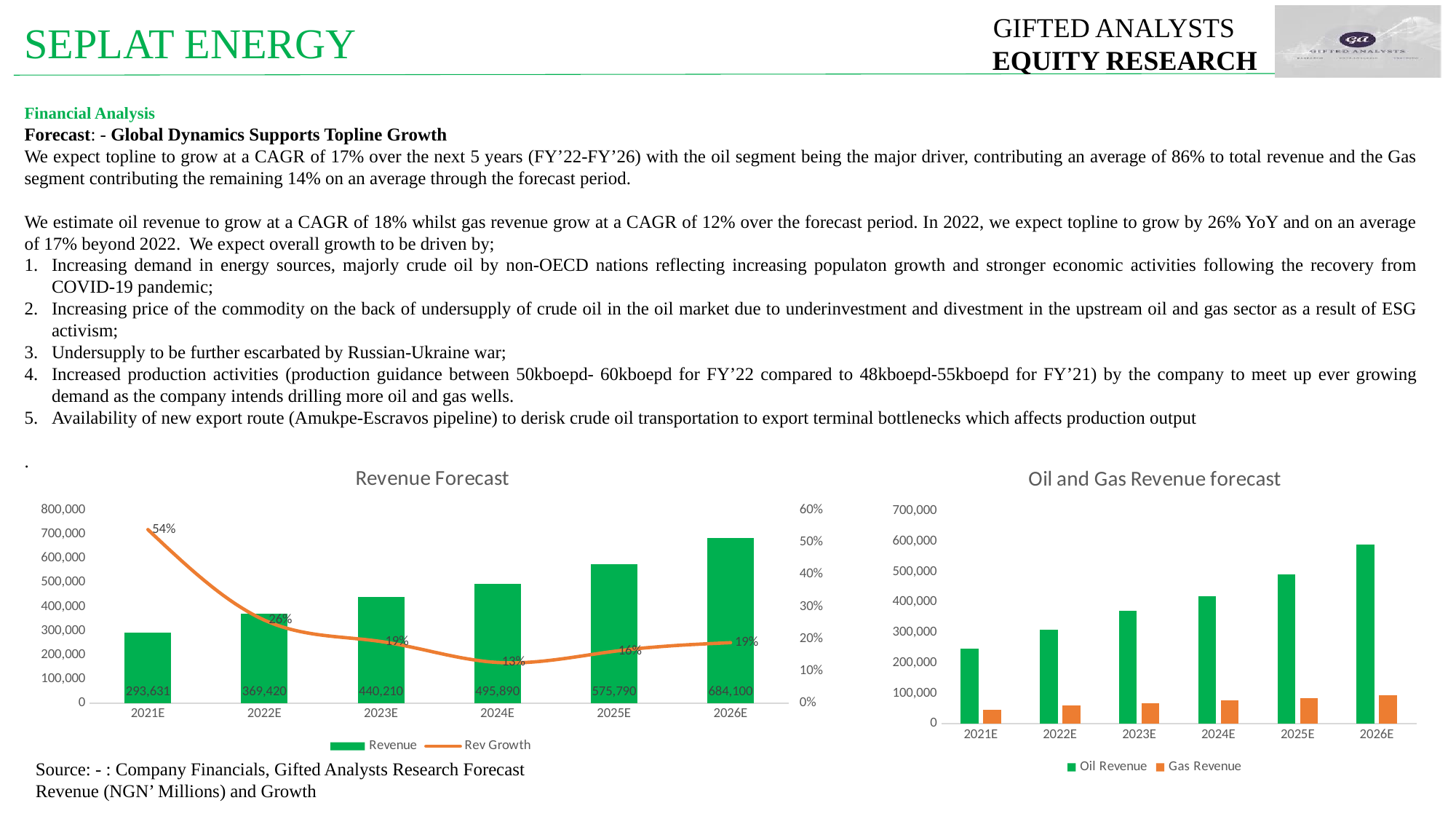
In the Revenue Forecast chart, what is the difference in revenue between 2026E and 2025E? 108,310 In the Revenue Forecast chart, what is the Rev Growth value for 2021E? 54% In the Revenue Forecast chart, is the Rev Growth for 2022E higher or lower than for 2025E? Higher In the Revenue Forecast chart, which year has the lowest Rev Growth? 2024E In the Revenue Forecast chart, does revenue rise or fall from 2021E to 2026E? Rise In the Revenue Forecast chart, what is the revenue value for 2023E? 440,210 In the Oil and Gas Revenue forecast chart, is the Gas Revenue for 2021E greater or less than 100,000? less In the Revenue Forecast chart, which year has the highest revenue? 2026E In the Revenue Forecast chart, how many series does the legend list? 2 In the Oil and Gas Revenue forecast chart, is the Oil Revenue for 2026E greater or less than 500,000? greater What kind of chart is the Oil and Gas Revenue forecast chart? Bar chart In the Oil and Gas Revenue forecast chart, how many years are shown on the x axis? 6